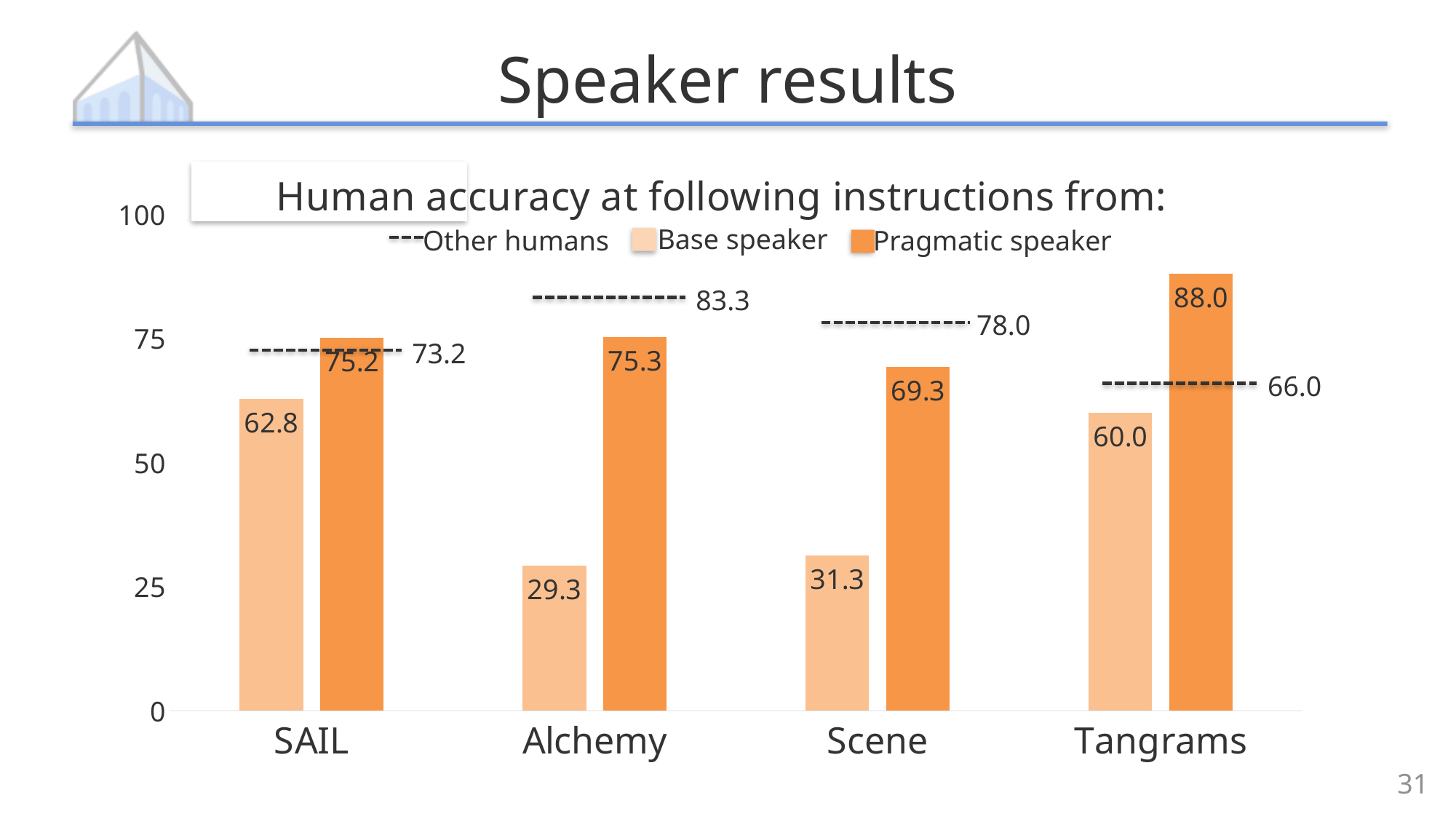
Which category has the lowest Base speaker value? Alchemy What is the Pragmatic speaker value for Tangrams? 88.0 What is the Base speaker value for Alchemy? 29.3 How many series does the legend list? 3 What is the Other humans value for Scene? 78.0 What is the difference between the Pragmatic speaker and Base speaker values for Alchemy? 46.0 How many categories are shown on the x axis? 4 Which is larger for SAIL: the Pragmatic speaker value or the Other humans value? Pragmatic speaker Is the Base speaker value for Scene greater or less than 50? less What kind of chart is this? bar chart What is the title of the chart? Human accuracy at following instructions from: Which category has the highest Pragmatic speaker value? Tangrams